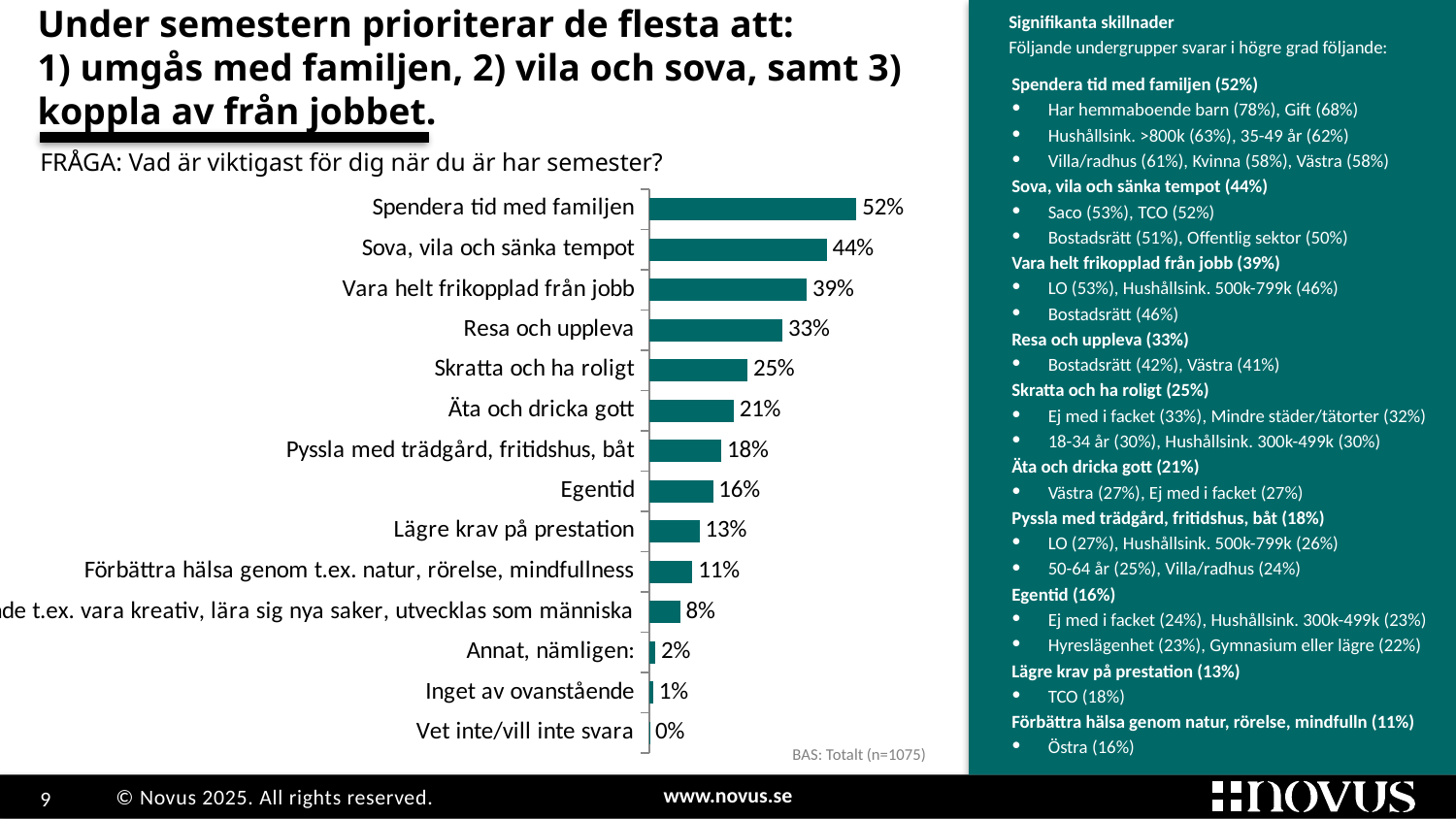
What kind of chart is shown on the slide? Bar chart What value does the bar for "Resa och uppleva" show? 33% What is the difference between the values for "Sova, vila och sänka tempot" and "Vara helt frikopplad från jobb"? 5% Which is larger, the value for "Pyssla med trädgård, fritidshus, båt" or the value for "Lägre krav på prestation"? Pyssla med trädgård, fritidshus, båt What is the base (n) stated below the chart? n=1075 What is the difference between "Skratta och ha roligt" and "Äta och dricka gott"? 4% What value is shown for "Annat, nämligen:"? 2% What percentage is shown for "Spendera tid med familjen"? 52% Which category has the lowest value in the chart? Vet inte/vill inte svara How many categories are plotted in the chart? 14 What percentage is shown for "Egentid"? 16% Which category has the highest value in the chart? Spendera tid med familjen